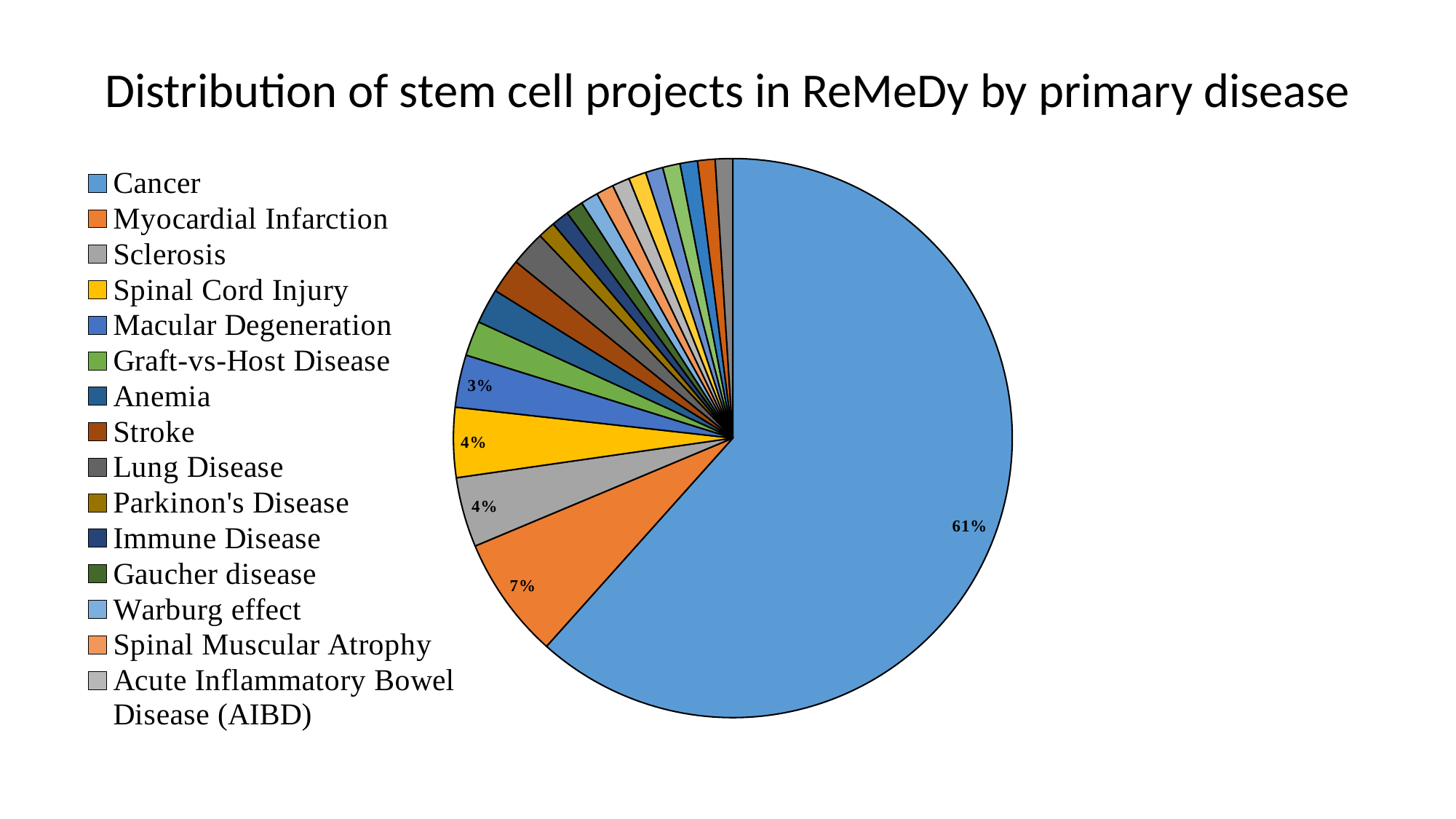
What percentage is shown for Myocardial Infarction? 7% What percentage is shown for Sclerosis? 4% What percentage is shown for Macular Degeneration? 3% What percentage is shown for Spinal Cord Injury? 4% How many percentage points larger is the Cancer share than the Myocardial Infarction share? 54 percentage points What kind of chart is shown on the slide? Pie chart What is the title of the chart? Distribution of stem cell projects in ReMeDy by primary disease What share of the pie does Cancer account for? 61% How many diseases are listed in the legend? 15 Which legend entry is shown in yellow? Spinal Cord Injury Which primary disease has the largest share of stem cell projects? Cancer Which has a larger share, Myocardial Infarction or Macular Degeneration? Myocardial Infarction